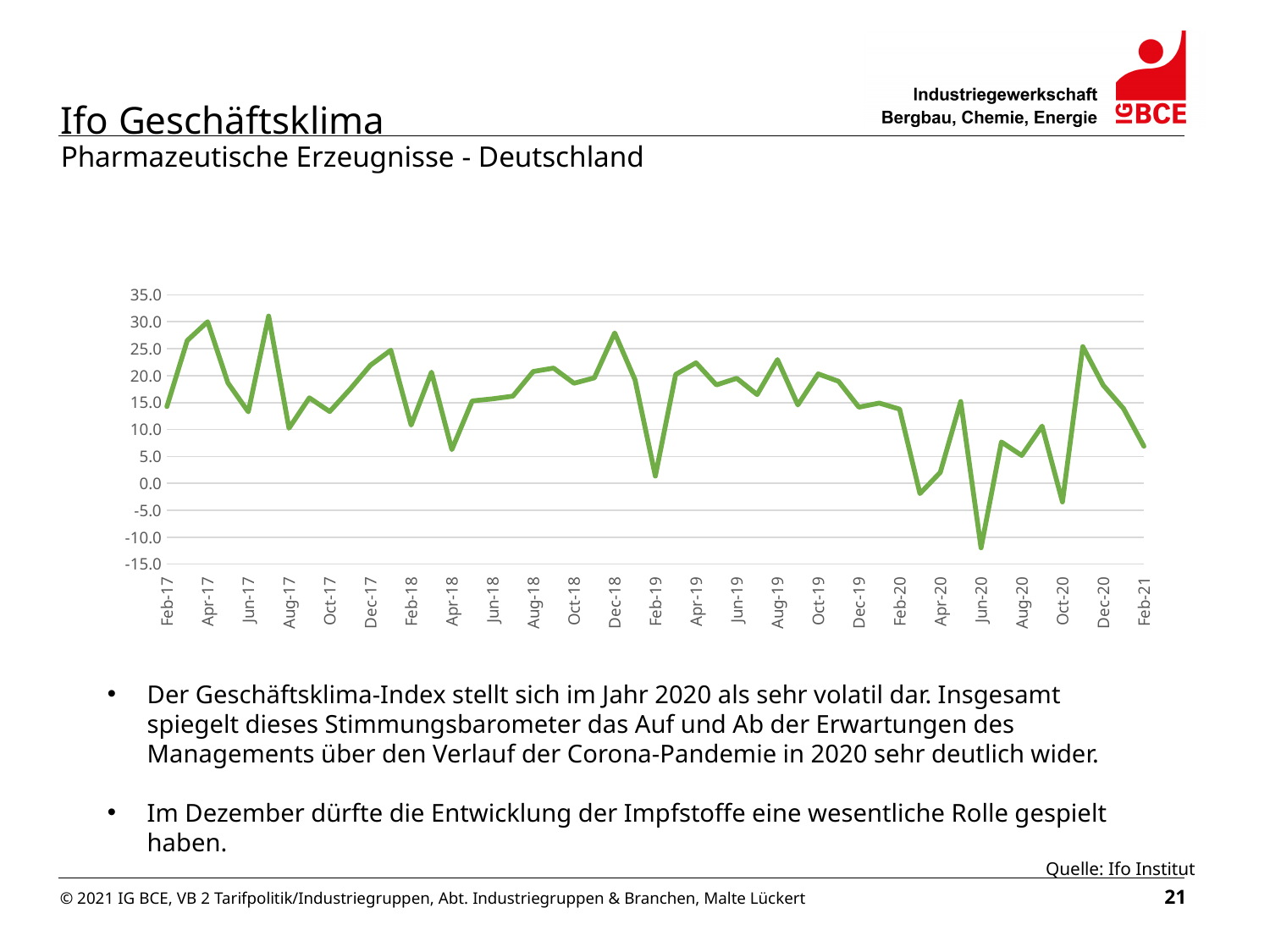
Is the value for Feb-19 greater or less than 5.0? less Which is larger, the value for Jun-20 or the value for Dec-20? Dec-20 Is the value for Dec-18 greater or less than 25.0? greater What kind of chart is shown on the slide? line chart Which is larger, the value for Dec-18 or the value for Feb-19? Dec-18 Is the value for Feb-21 greater or less than 10.0? less Which month shows the lowest value on the chart? Jun-20 What is the highest value shown on the y axis? 35.0 Does the line rise or fall between Dec-20 and Feb-21? fall